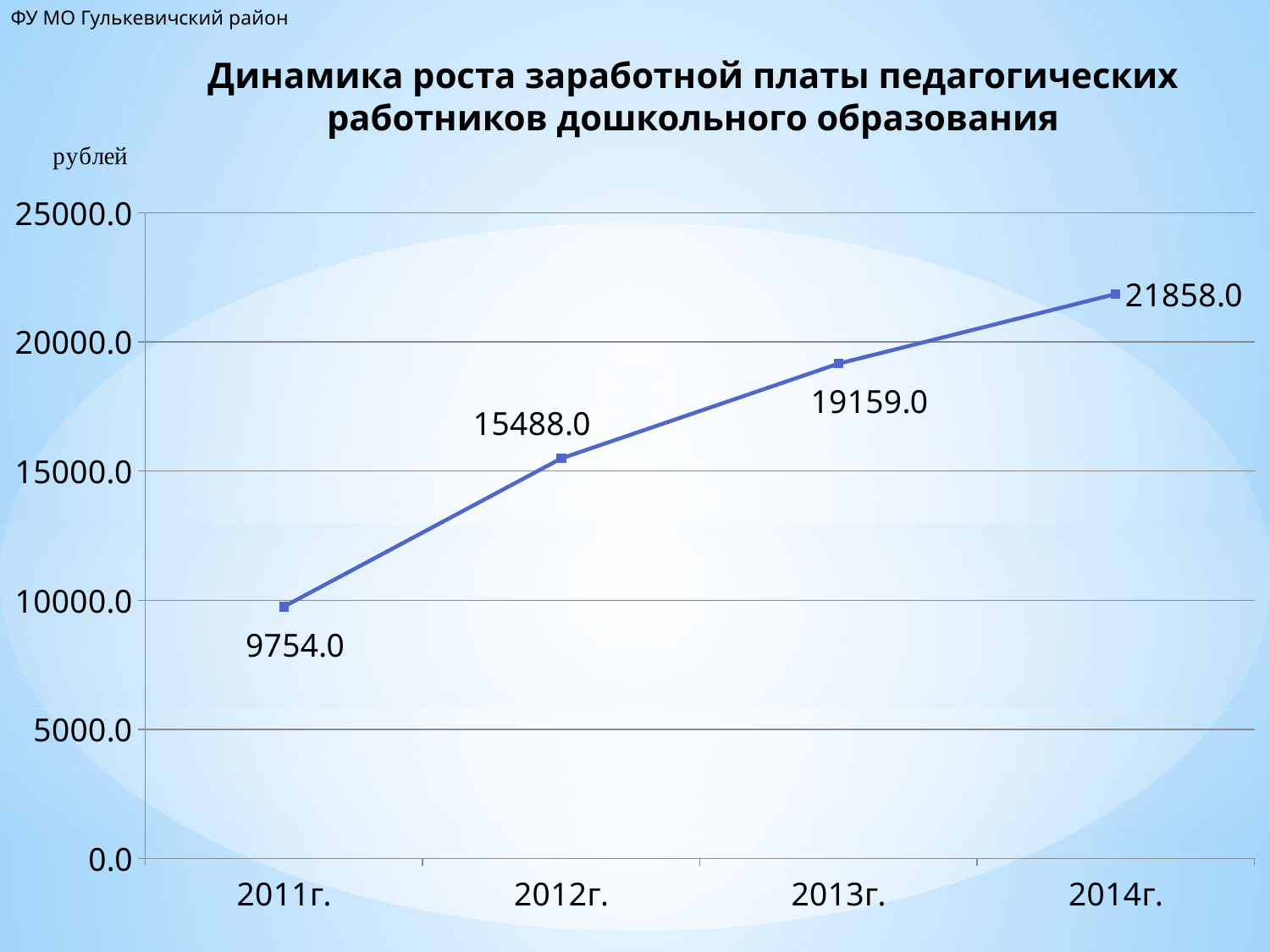
What is the value for 2013г.? 19159.0 How many data points are plotted on the chart? 4 What is the value for 2011г.? 9754.0 Which is larger, the value for 2013г. or the value for 2012г.? 2013г. Is the value for 2013г. greater or less than 20000.0? less What is the difference between the values for 2012г. and 2011г.? 5734.0 What kind of chart is shown on the slide? line chart What is the value for 2014г.? 21858.0 Which year has the highest value? 2014г. What is the difference between the values for 2014г. and 2011г.? 12104.0 What is the value for 2012г.? 15488.0 Which year has the lowest value? 2011г.